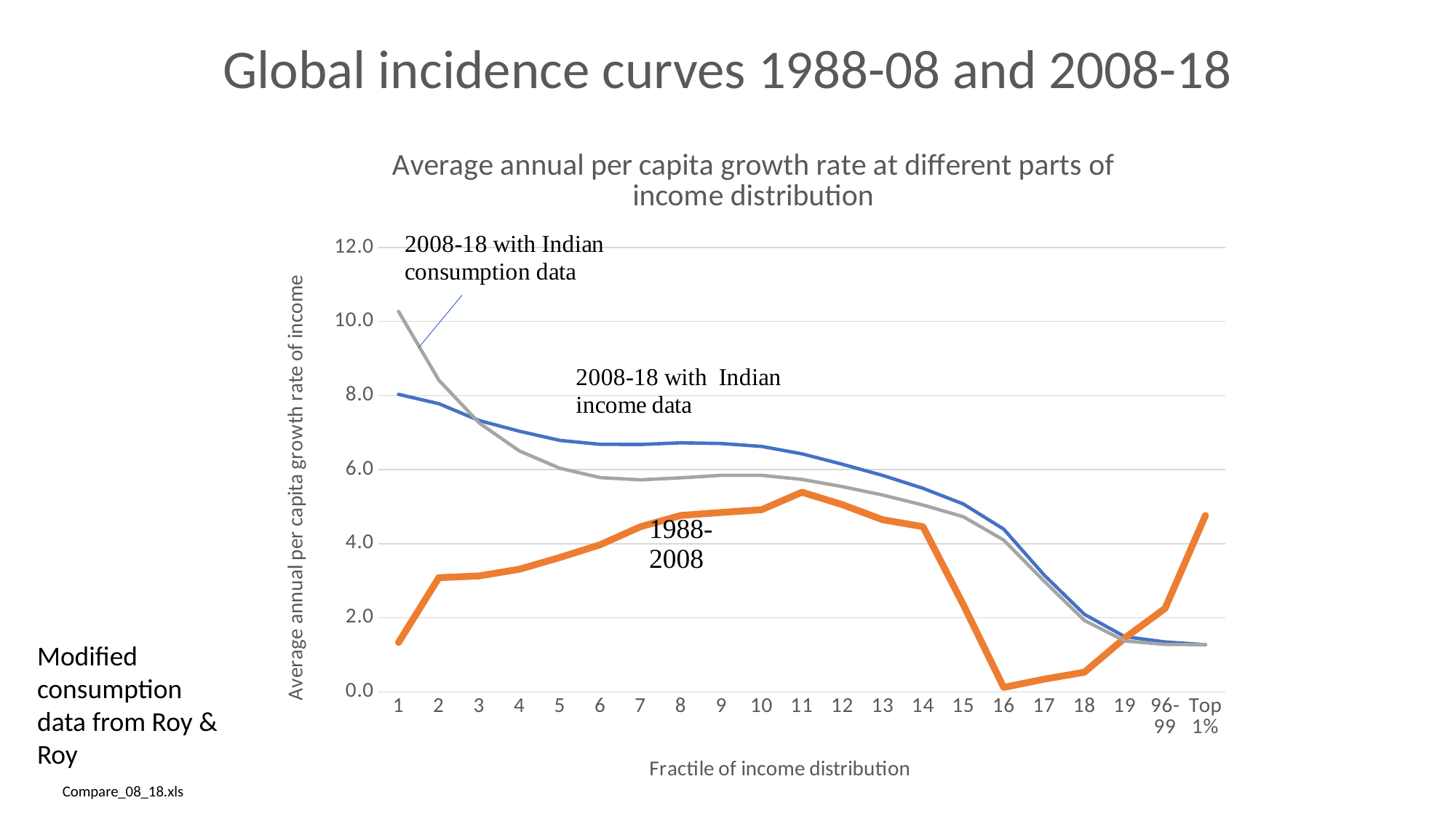
What kind of chart is shown on the slide? line chart At which fractile does the 2008-18 with Indian consumption data series reach its highest value? 1 At which fractile does the 1988-2008 series reach its lowest value? 16 How many series (lines) are plotted on the chart? 3 How many fractile categories are shown on the x axis? 21 Is the value of the 1988-2008 series at Top 1% greater or less than 4.0? greater Does the 2008-18 with Indian income data series rise or fall from fractile 1 to fractile 19? fall Is the value of the 1988-2008 series at fractile 16 greater or less than 2.0? less What is the title of the x axis? Fractile of income distribution Is the value of the 2008-18 with Indian consumption data series at fractile 1 greater or less than 8.0? greater At fractile 1, which series is higher: 2008-18 with Indian consumption data or 2008-18 with Indian income data? 2008-18 with Indian consumption data